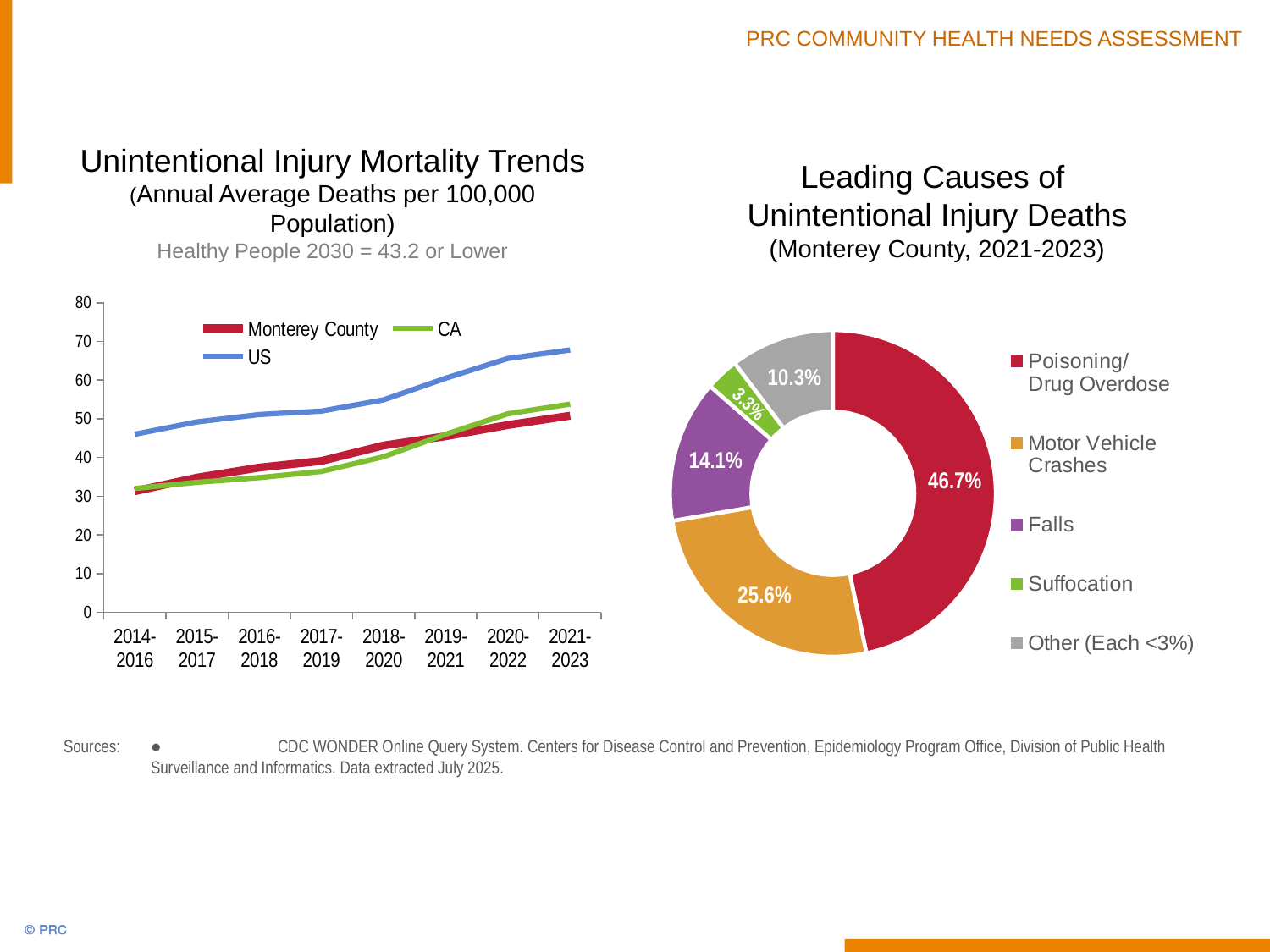
What kind of chart is the Unintentional Injury Mortality Trends chart? Line chart In the Leading Causes of Unintentional Injury Deaths chart, which cause has the largest share? Poisoning/Drug Overdose In the Unintentional Injury Mortality Trends chart, does the US line rise or fall from 2014-2016 to 2021-2023? Rise How many series does the legend of the Unintentional Injury Mortality Trends chart list? 3 How many categories does the Leading Causes of Unintentional Injury Deaths chart show? 5 In the Unintentional Injury Mortality Trends chart, is the US value for 2021-2023 greater or less than 60? greater In the Leading Causes of Unintentional Injury Deaths chart, which is larger, Falls or Other (Each <3%)? Falls In the Leading Causes of Unintentional Injury Deaths chart, which cause has the smallest share? Suffocation In the Leading Causes of Unintentional Injury Deaths chart, what is the difference in percentage points between Poisoning/Drug Overdose and Motor Vehicle Crashes? 21.1 In the Leading Causes of Unintentional Injury Deaths chart, what share is Poisoning/Drug Overdose? 46.7% In the Leading Causes of Unintentional Injury Deaths chart, what share is Motor Vehicle Crashes? 25.6% In the Leading Causes of Unintentional Injury Deaths chart, what share is Falls? 14.1%